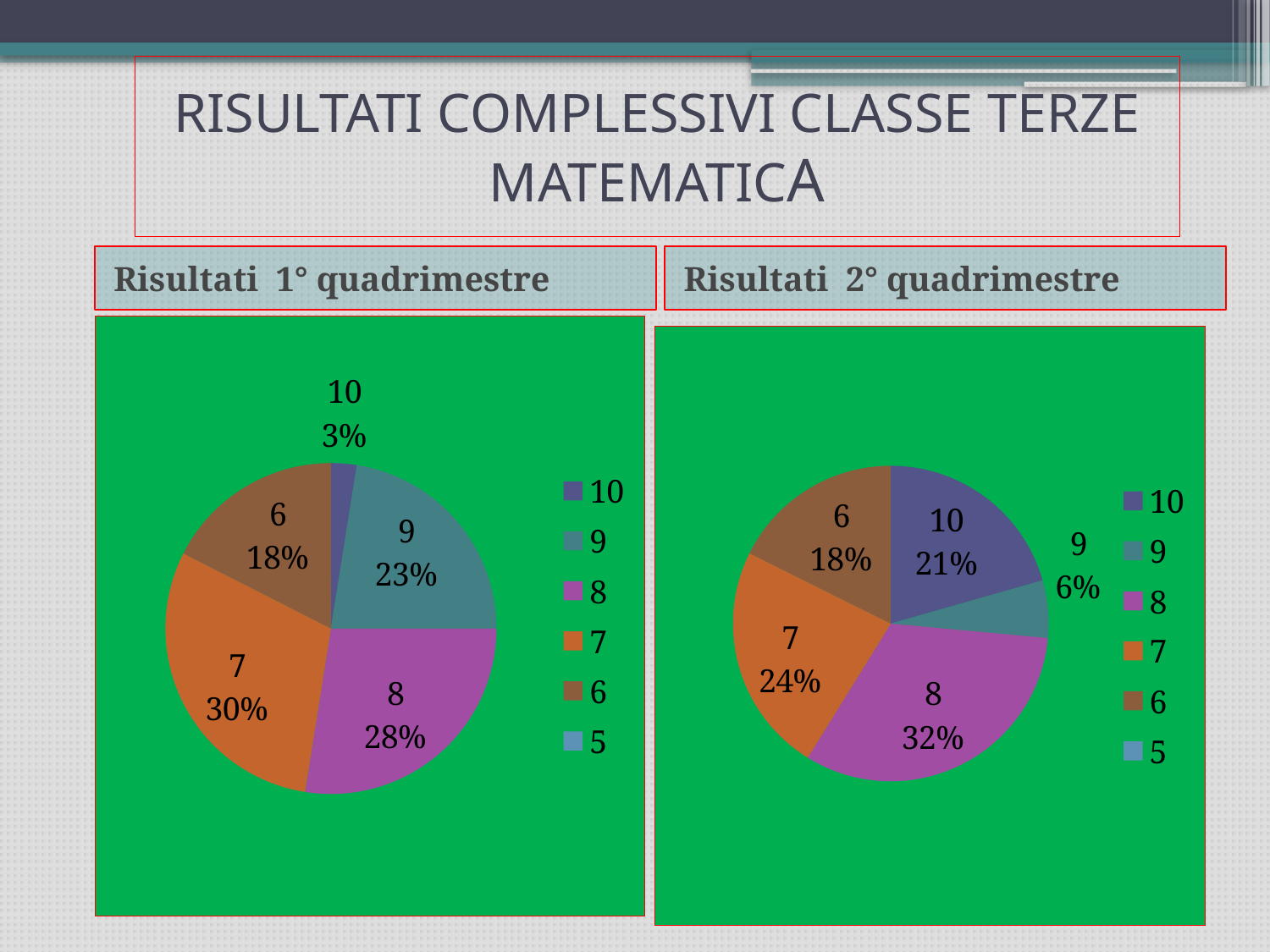
In the 'Risultati 1° quadrimestre' chart, what colour is the slice for grade 8? purple In the 'Risultati 2° quadrimestre' chart, what share does grade 8 have? 32% What kind of chart is the 'Risultati 2° quadrimestre' chart? pie chart In the 'Risultati 1° quadrimestre' chart, which grade has the smallest share? 10 How many slices with labels are shown in the 'Risultati 2° quadrimestre' pie? 5 In the 'Risultati 1° quadrimestre' chart, what share does grade 7 have? 30% In the 'Risultati 1° quadrimestre' chart, which is larger, the share for grade 9 or the share for grade 6? 9 In the 'Risultati 2° quadrimestre' chart, which grade has the smallest share? 9 In the 'Risultati 2° quadrimestre' chart, which grade has the largest share? 8 How many entries does the legend of the 'Risultati 1° quadrimestre' chart list? 6 In the 'Risultati 1° quadrimestre' chart, which grade has the largest share? 7 In the 'Risultati 2° quadrimestre' chart, what is the difference in percentage points between the share for grade 8 and the share for grade 7? 8